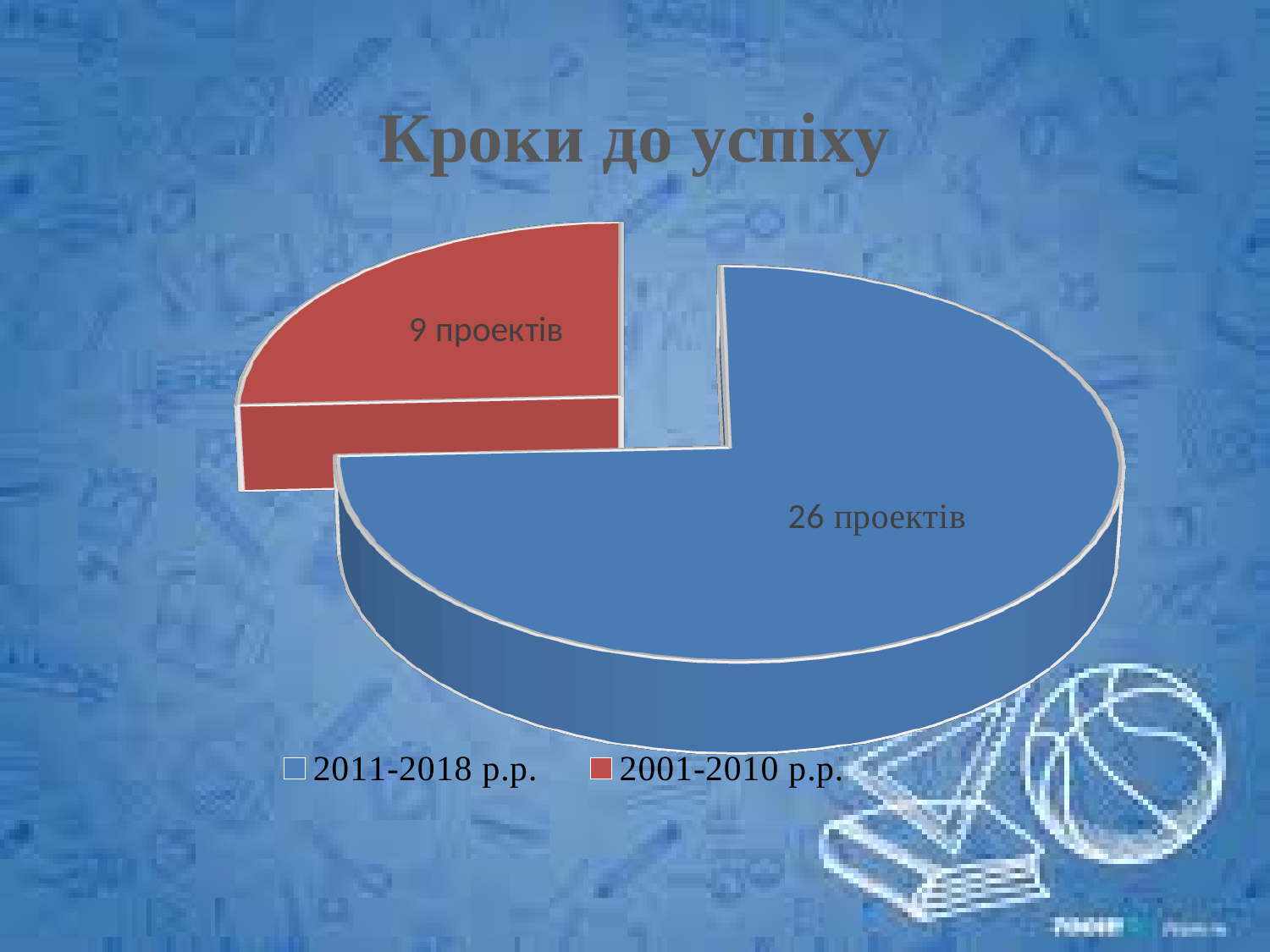
What colour is the slice for 2001-2010 р.р.? red Which period has the larger slice of the pie? 2011-2018 р.р. What kind of chart is shown on the slide? pie chart How many entries does the legend list? 2 How many projects are shown for 2011-2018 р.р.? 26 проектів What is the title of the chart on the slide? Кроки до успіху How many more projects are there in 2011-2018 р.р. than in 2001-2010 р.р.? 17 How many projects are shown for 2001-2010 р.р.? 9 проектів Which period has the smaller slice of the pie? 2001-2010 р.р. What is the total number of projects across both slices? 35 Which has more projects: 2001-2010 р.р. or 2011-2018 р.р.? 2011-2018 р.р. How many slices does the pie chart have? 2